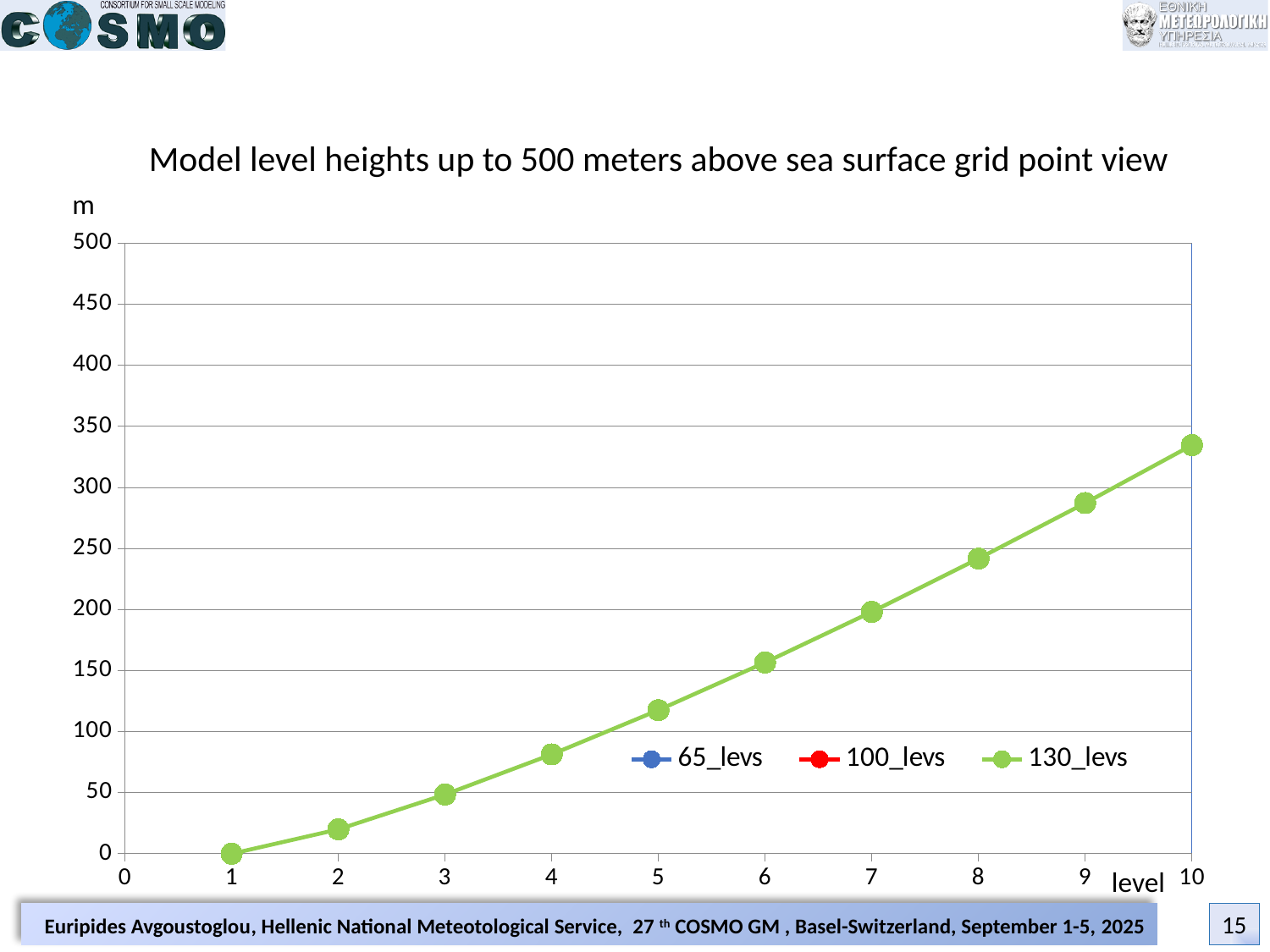
What kind of chart is shown on the slide? line chart Is the value at level 2 greater or less than 50? less How many series does the legend list? 3 Is the value at level 5 greater or less than 100? greater Is the value at level 10 greater or less than 300? greater How many data points are plotted on the visible line? 10 At which level is the plotted height lowest? 1 Which series in the legend is drawn in green? 130_levs Do the plotted heights rise or fall as the level number increases? rise What is the title of the chart? Model level heights up to 500 meters above sea surface grid point view At which level is the plotted height highest? 10